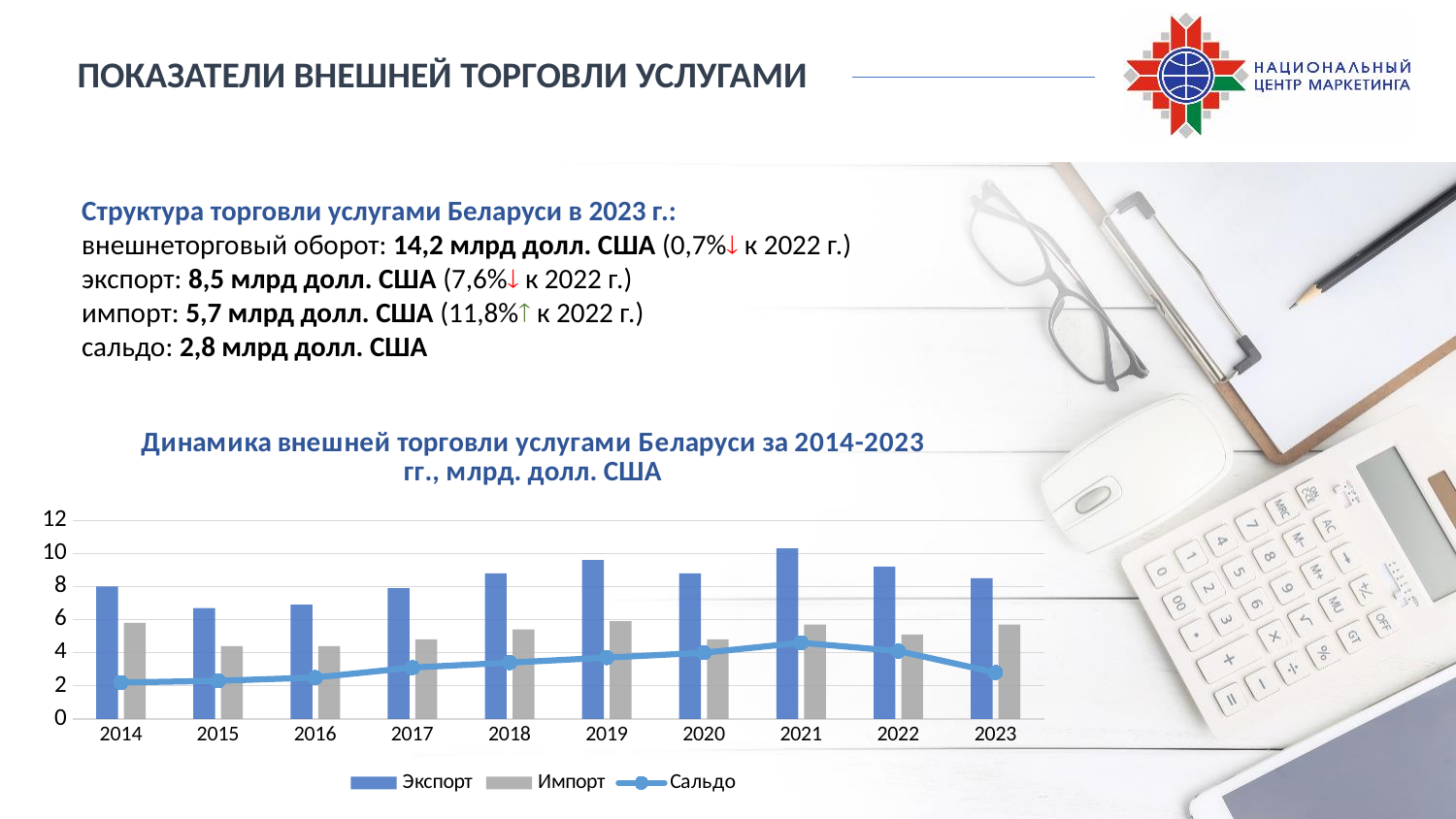
How many years are shown on the x axis of the chart? 10 Does the Сальдо line rise or fall from 2014 to 2021? rise Is the value of Импорт for 2017 greater or less than 6? less Is the value of Экспорт for 2015 greater or less than 8? less What kind of chart is shown on the slide? Combined bar and line chart Is the value of Сальдо for 2014 greater or less than 4? less Which is larger: Экспорт in 2021 or Экспорт in 2014? Экспорт in 2021 Which series is shown as a line in the chart? Сальдо Does the Сальдо line rise or fall from 2021 to 2023? fall How many series does the legend of the chart list? 3 In which year is the Экспорт bar the highest? 2021